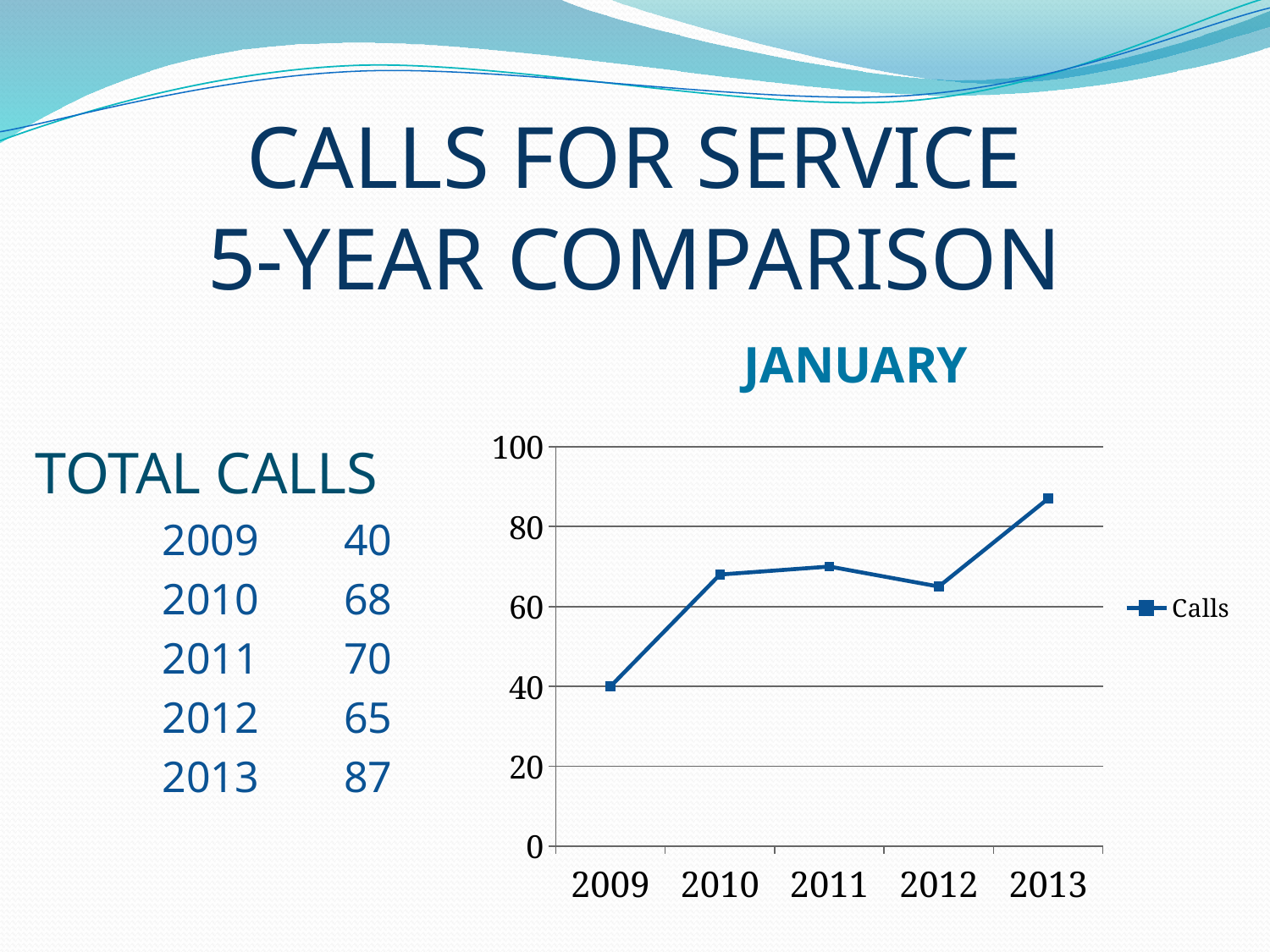
Which year has more calls, 2011 or 2012? 2011 What type of chart is shown on the slide? line chart Which year has the highest number of calls? 2013 Is the value for 2013 greater or less than 80? greater What is the number of calls for 2012? 65 What is the number of calls for 2013? 87 What is the number of calls for 2009? 40 How many years are plotted on the x axis? 5 What is the chart's title? JANUARY How many series does the legend list? 1 Which year has the lowest number of calls? 2009 What is the difference in calls between 2013 and 2009? 47